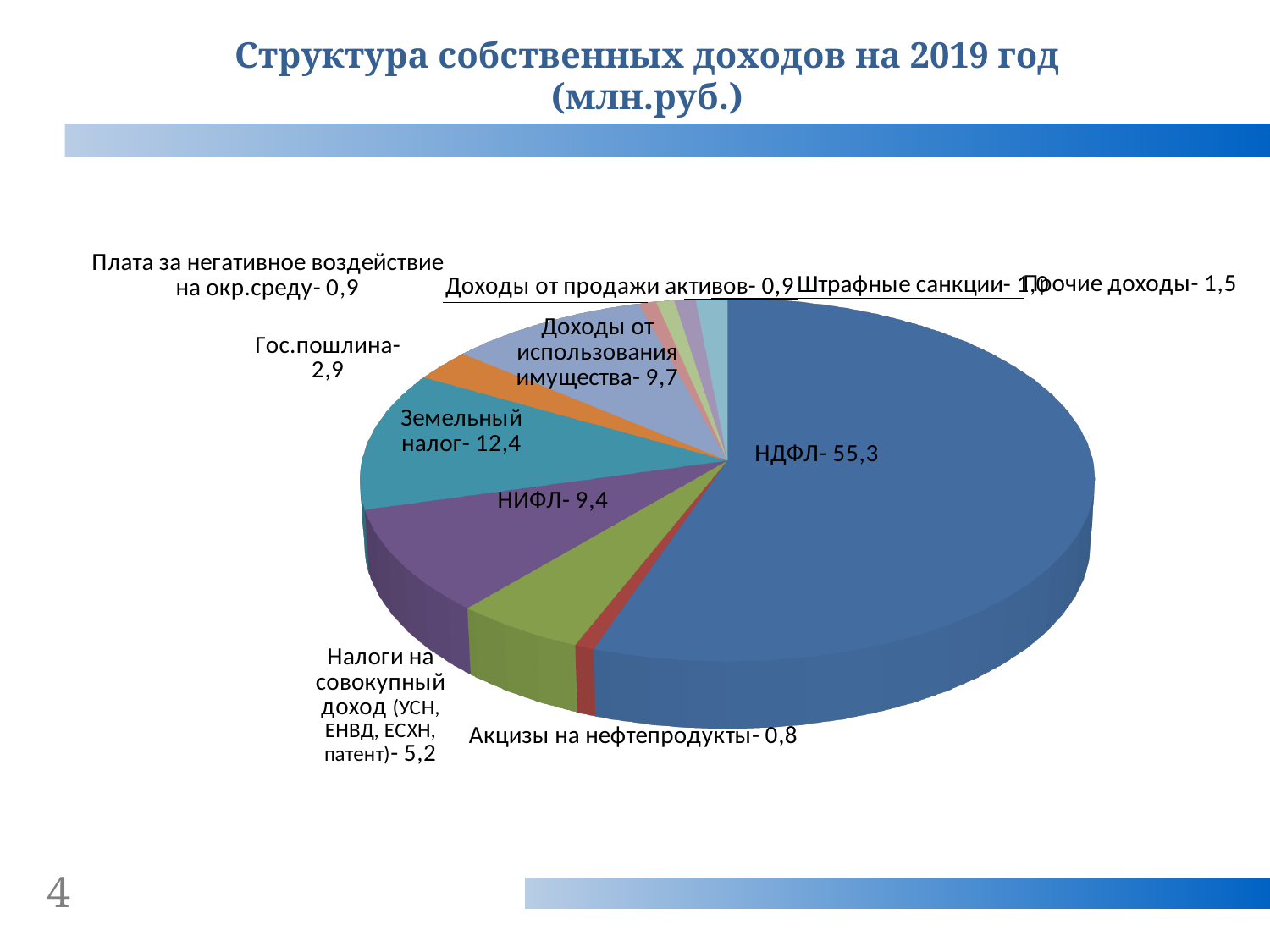
What is the value for Гос.пошлина? 2,9 What is the value for НДФЛ? 55,3 Which category has the smallest value? Акцизы на нефтепродукты What kind of chart is shown on the slide? Pie chart What is the value for Доходы от использования имущества? 9,7 Which is larger, Земельный налог or Доходы от использования имущества? Земельный налог Which category has the largest slice of the pie? НДФЛ What is the difference between Земельный налог and НИФЛ? 3,0 What is the value for Налоги на совокупный доход (УСН, ЕНВД, ЕСХН, патент)? 5,2 What is the title of the chart? Структура собственных доходов на 2019 год (млн.руб.) How many slices does the pie chart have? 11 What is the value for Земельный налог? 12,4